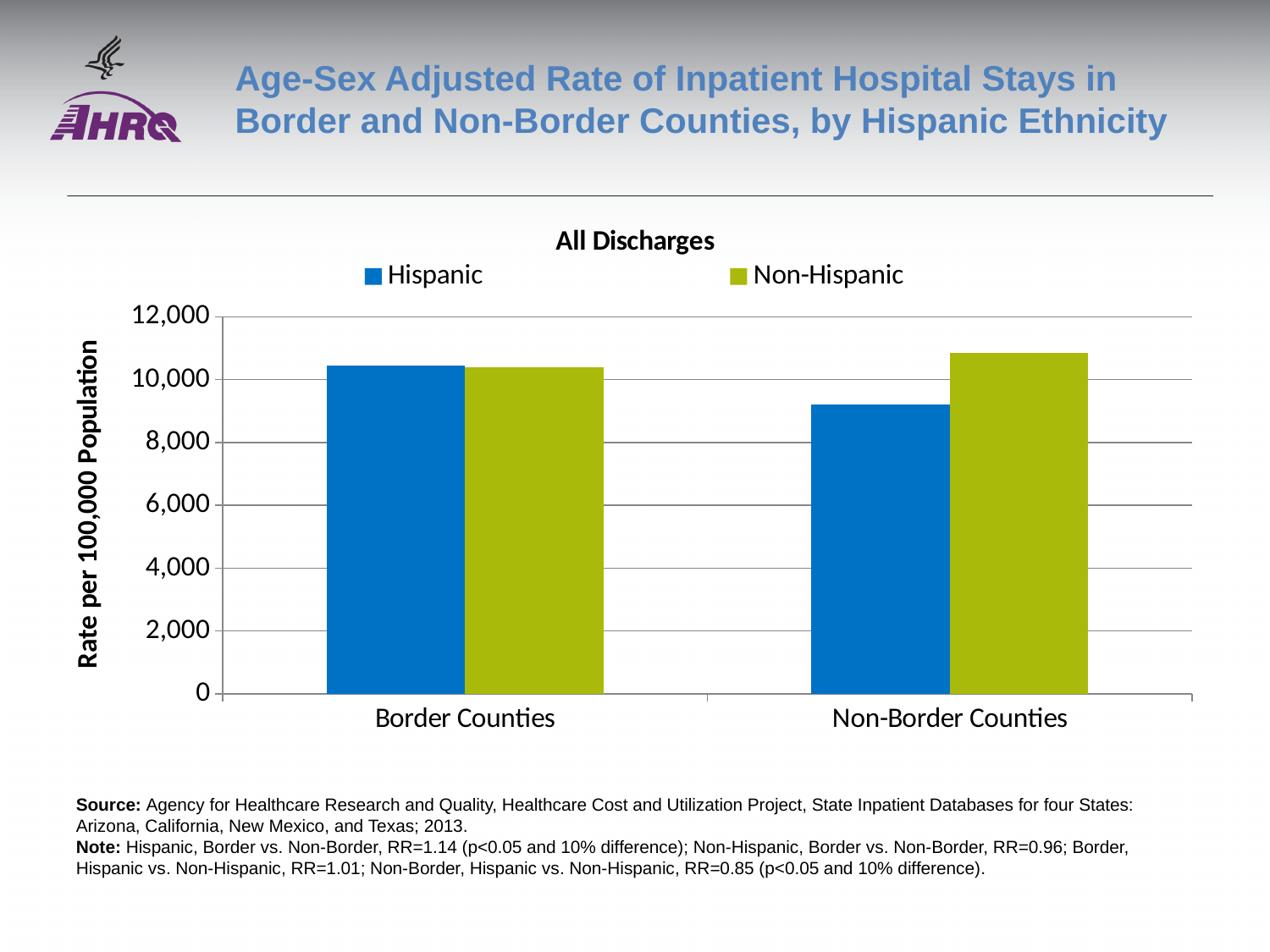
How many categories are shown on the x axis? 2 Is the Hispanic value for Non-Border Counties greater or less than 10,000? less Which bar is the lowest on the chart? Hispanic, Non-Border Counties Which bar is the highest on the chart? Non-Hispanic, Non-Border Counties What is the label of the y axis? Rate per 100,000 Population In Non-Border Counties, which is larger: the Hispanic or the Non-Hispanic rate? Non-Hispanic Is the Non-Hispanic value for Non-Border Counties greater or less than 10,000? greater Is the Non-Hispanic value for Border Counties greater or less than 12,000? less How many series does the legend list? 2 What kind of chart is shown on the slide? Bar chart What is the title of the chart? All Discharges